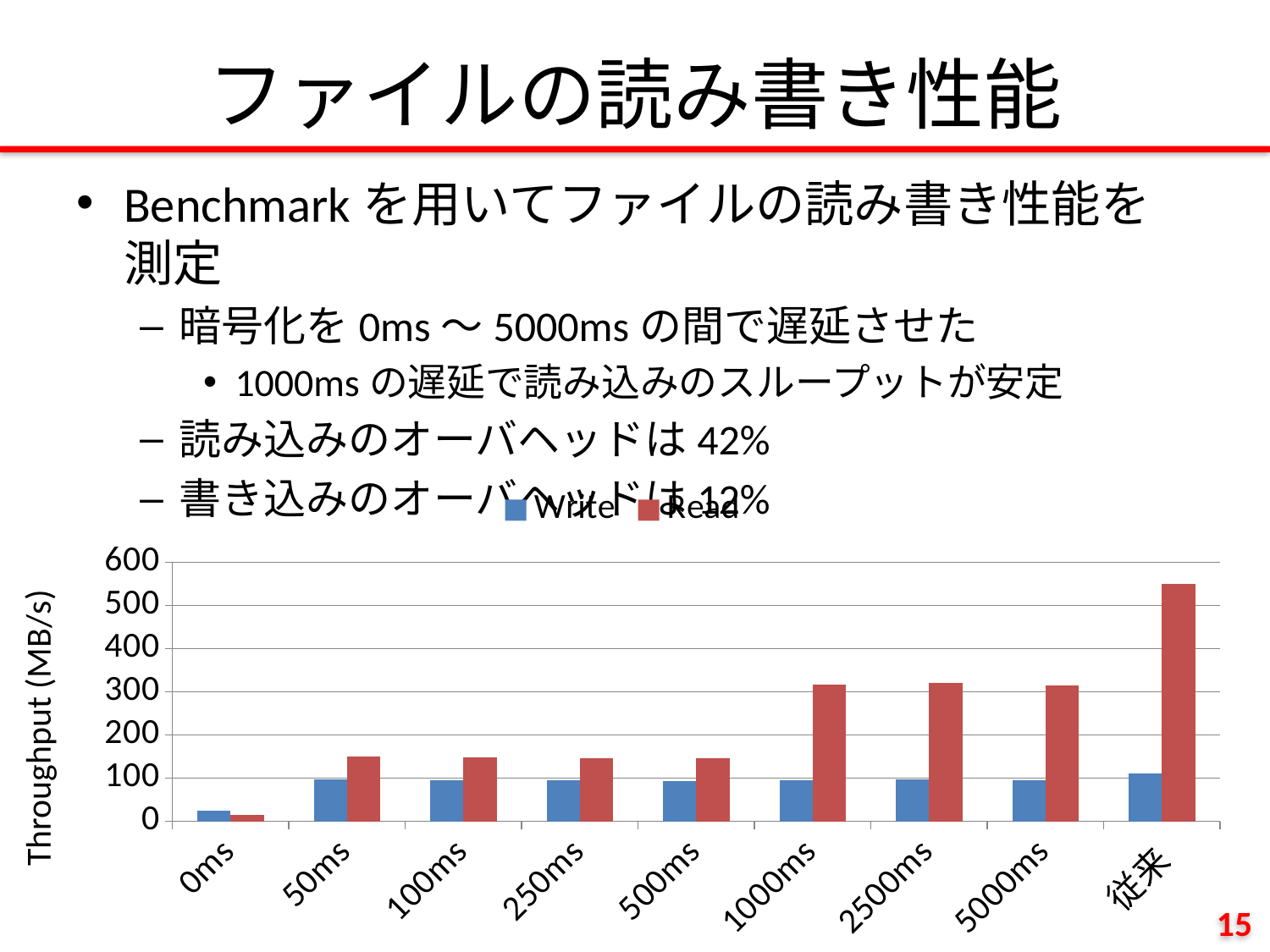
Which category has the highest Read throughput? 従来 Which category has the lowest Write throughput? 0ms What is the label of the vertical axis? Throughput (MB/s) How many categories are shown on the x axis? 9 How many series does the legend list? 2 Which category has the lowest Read throughput? 0ms Which is larger at 2500ms, the Write value or the Read value? Read Is the Read value for 従来 greater or less than 500? greater Which is larger at 0ms, the Write value or the Read value? Write Is the Read value for 1000ms greater or less than 300? greater What kind of chart is shown on the slide? bar chart